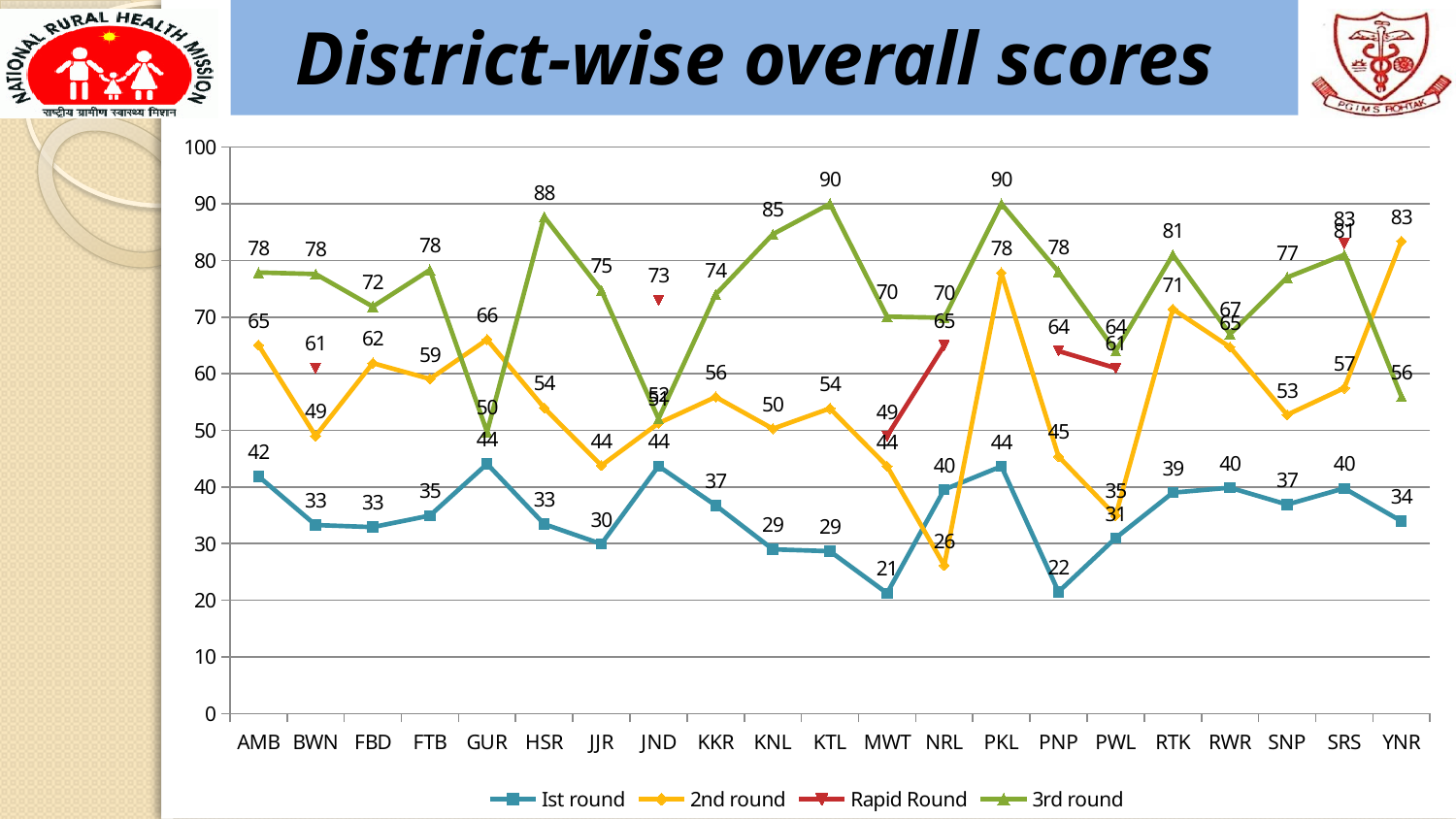
What is the Ist round score for PNP? 22 What is the 3rd round score for HSR? 88 Which district has the lowest Ist round score? MWT Which district has the highest 2nd round score? YNR What kind of chart is shown on the slide? line chart For GUR, which is larger: the 2nd round score or the 3rd round score? 2nd round What is the Rapid Round score for JND? 73 How many series does the legend list? 4 What is the 2nd round score for NRL? 26 What is the difference between the 3rd round and Ist round scores for PKL? 46 How many districts are shown on the x axis? 21 Does the Ist round score rise or fall from KKR to MWT? fall